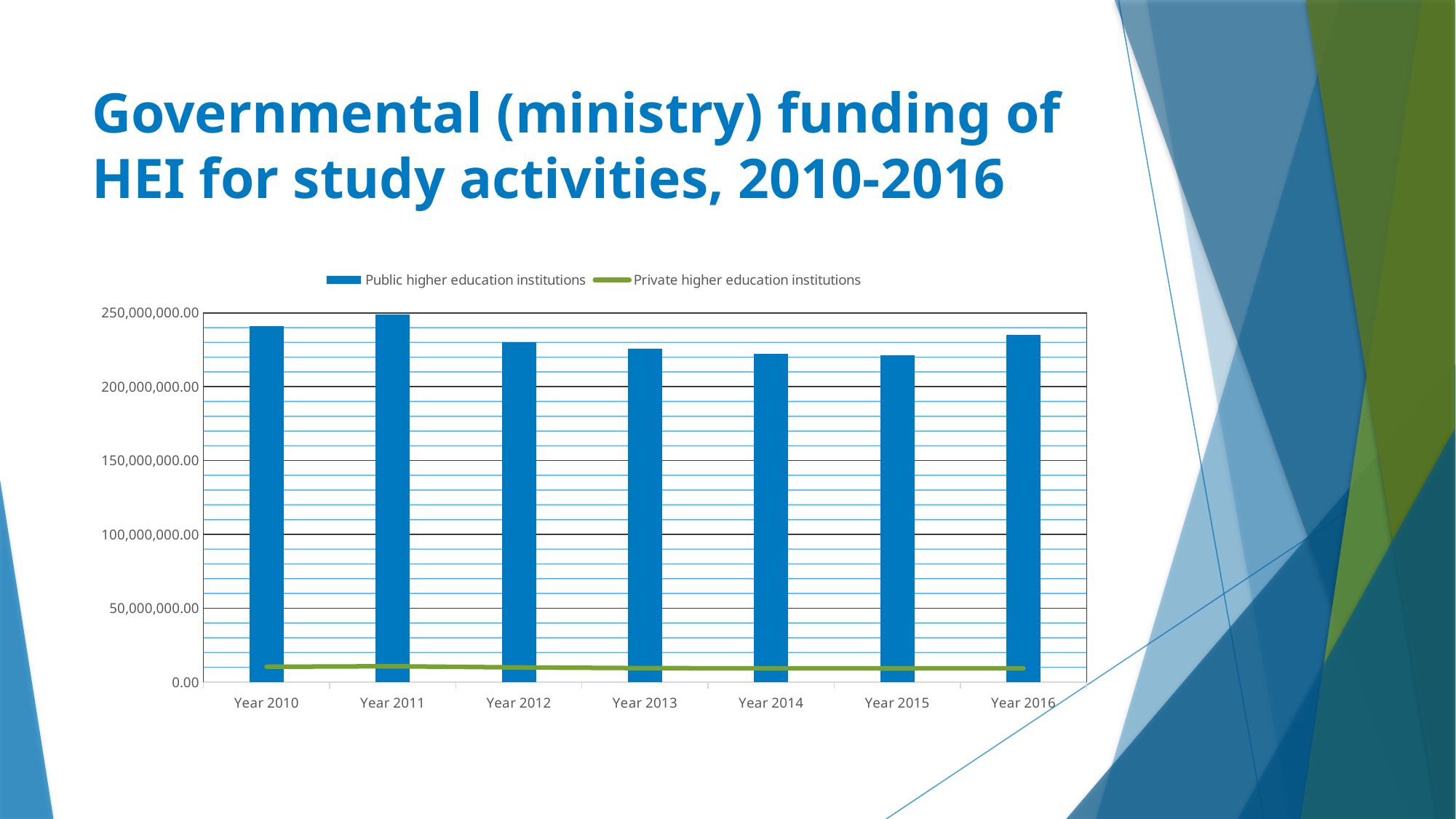
Which is larger for Public higher education institutions: Year 2010 or Year 2012? Year 2010 Is the value for Public higher education institutions in Year 2010 greater or less than 200,000,000.00? greater Do the values for Public higher education institutions rise or fall from Year 2011 to Year 2015? fall How many series does the legend list? 2 Which year has the highest value for Public higher education institutions? Year 2011 Which is larger for Public higher education institutions: Year 2011 or Year 2015? Year 2011 What kind of chart is used for the Public higher education institutions series? bar chart Is the value for Public higher education institutions in Year 2015 greater or less than 150,000,000.00? greater Is the value for Private higher education institutions in Year 2010 greater or less than 50,000,000.00? less How many years are shown on the x axis? 7 What colour represents Private higher education institutions in the legend? green